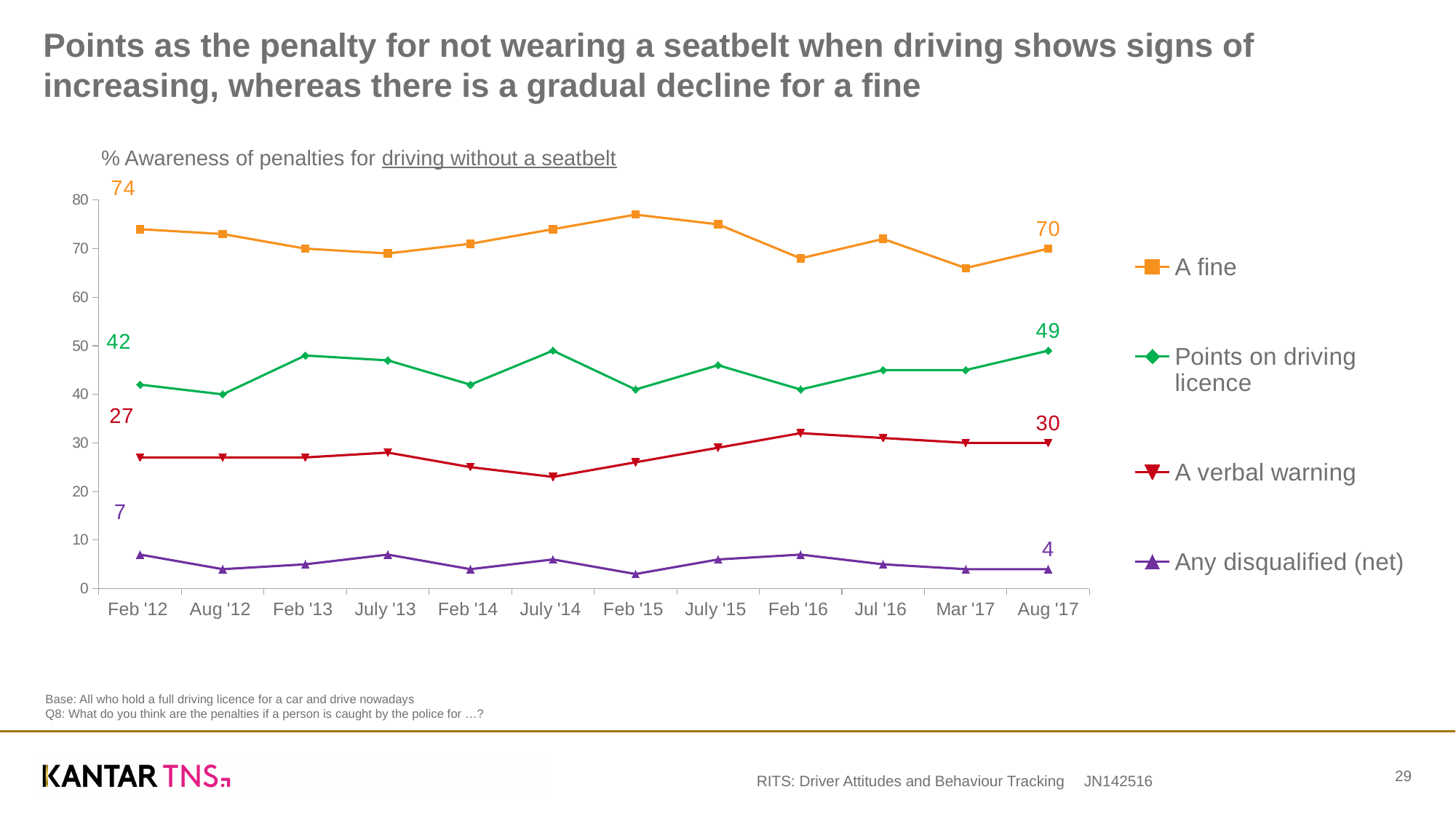
What is the value for 'Any disqualified (net)' in Aug '17? 4 Which series has the highest value in Aug '17? A fine How many series does the legend list? 4 Which series has the lowest value in Feb '12? Any disqualified (net) How many time points are shown on the x axis? 12 By how much did the value for 'A fine' change between Feb '12 and Aug '17? 4 What is the difference between 'Points on driving licence' and 'A verbal warning' in Aug '17? 19 Is the value for 'A fine' in Feb '15 greater or less than 70? greater What is the value for 'A verbal warning' in Feb '12? 27 What is the value for 'Points on driving licence' in Aug '17? 49 What is the value for 'A fine' in Feb '12? 74 What kind of chart is shown on the slide? Line chart